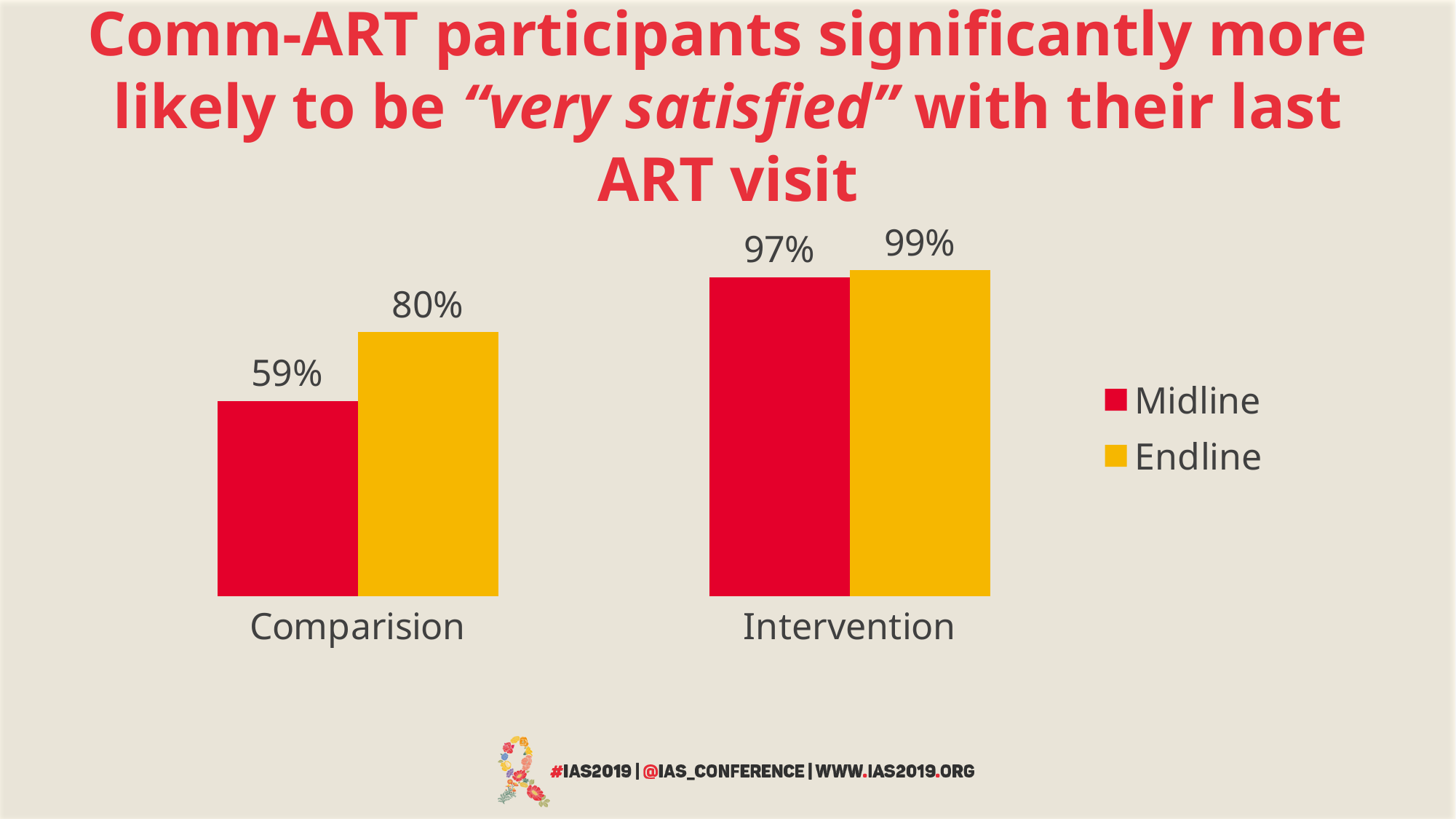
What is the Midline value for Intervention? 97% How many series does the legend list? 2 Which is larger, the Endline value for Comparision or the Midline value for Intervention? Midline value for Intervention What is the Endline value for Comparision? 80% How many categories are shown on the x axis? 2 What is the Midline value for Comparision? 59% Which category has the highest Endline value? Intervention What is the difference between the Endline and Midline values for Comparision? 21% What kind of chart is shown on the slide? Bar chart What is the difference between the Intervention and Comparision Midline values? 38% What is the Endline value for Intervention? 99% Which category has the lowest Midline value? Comparision